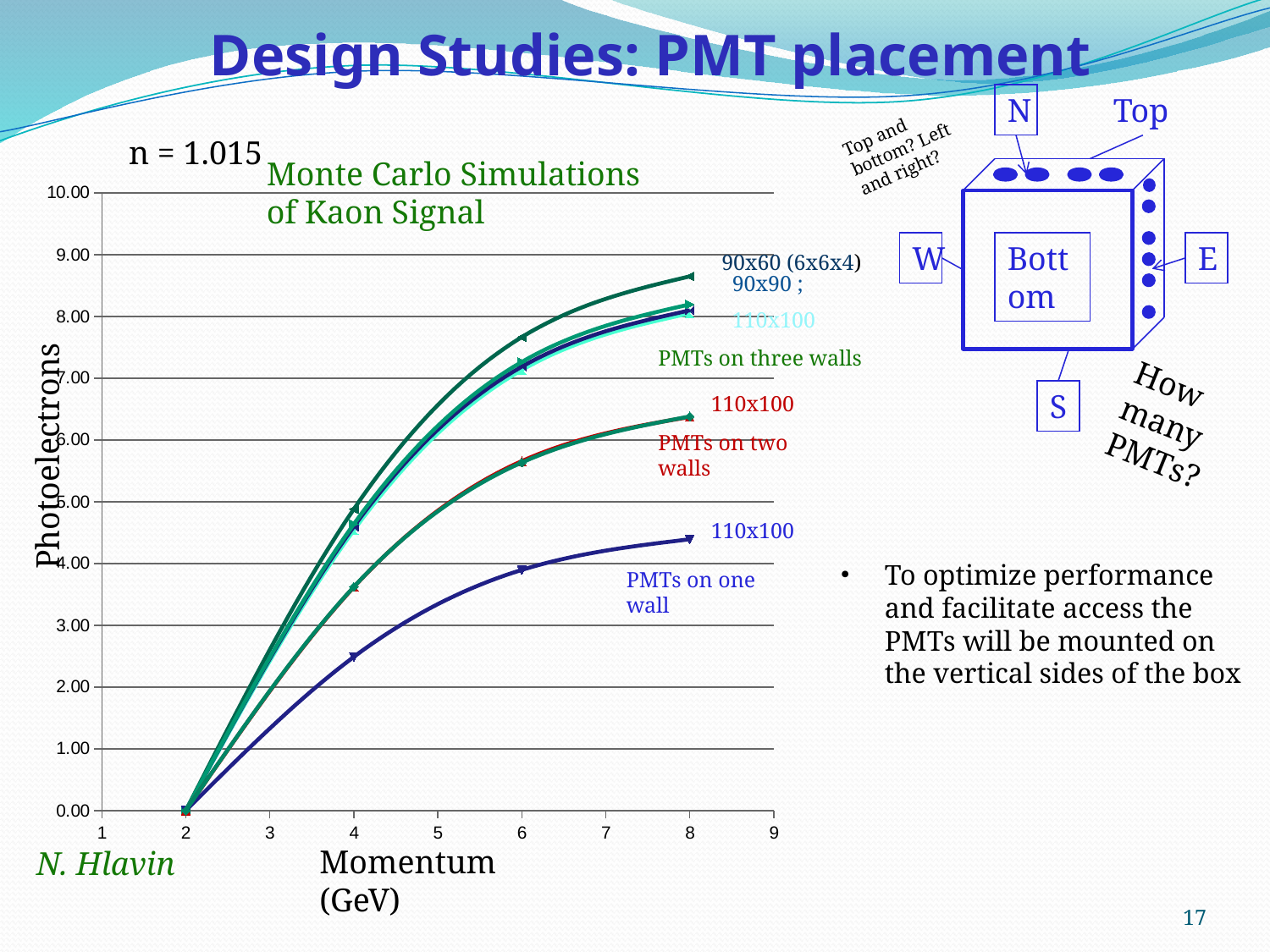
Which PMT configuration gives the lowest number of photoelectrons at a momentum of 8 GeV? PMTs on one wall What kind of chart is shown on the slide? line chart Is the photoelectron value for the 90x60 PMTs on three walls curve at 8 GeV greater or less than 8.00? greater Is the photoelectron value for PMTs on one wall at 4 GeV greater or less than 3.00? less At a momentum of 8 GeV, which gives more photoelectrons: PMTs on two walls or PMTs on one wall? PMTs on two walls What is the photoelectron value of the curves at a momentum of 2 GeV? 0.00 What quantity is plotted on the y axis of the chart? Photoelectrons Is the photoelectron value for PMTs on two walls at 8 GeV greater or less than 6.00? greater Do the photoelectron curves rise or fall as momentum increases? rise What is the title of the chart on the slide? Monte Carlo Simulations of Kaon Signal Which PMT configuration gives the highest number of photoelectrons at a momentum of 8 GeV? PMTs on three walls (90x60)